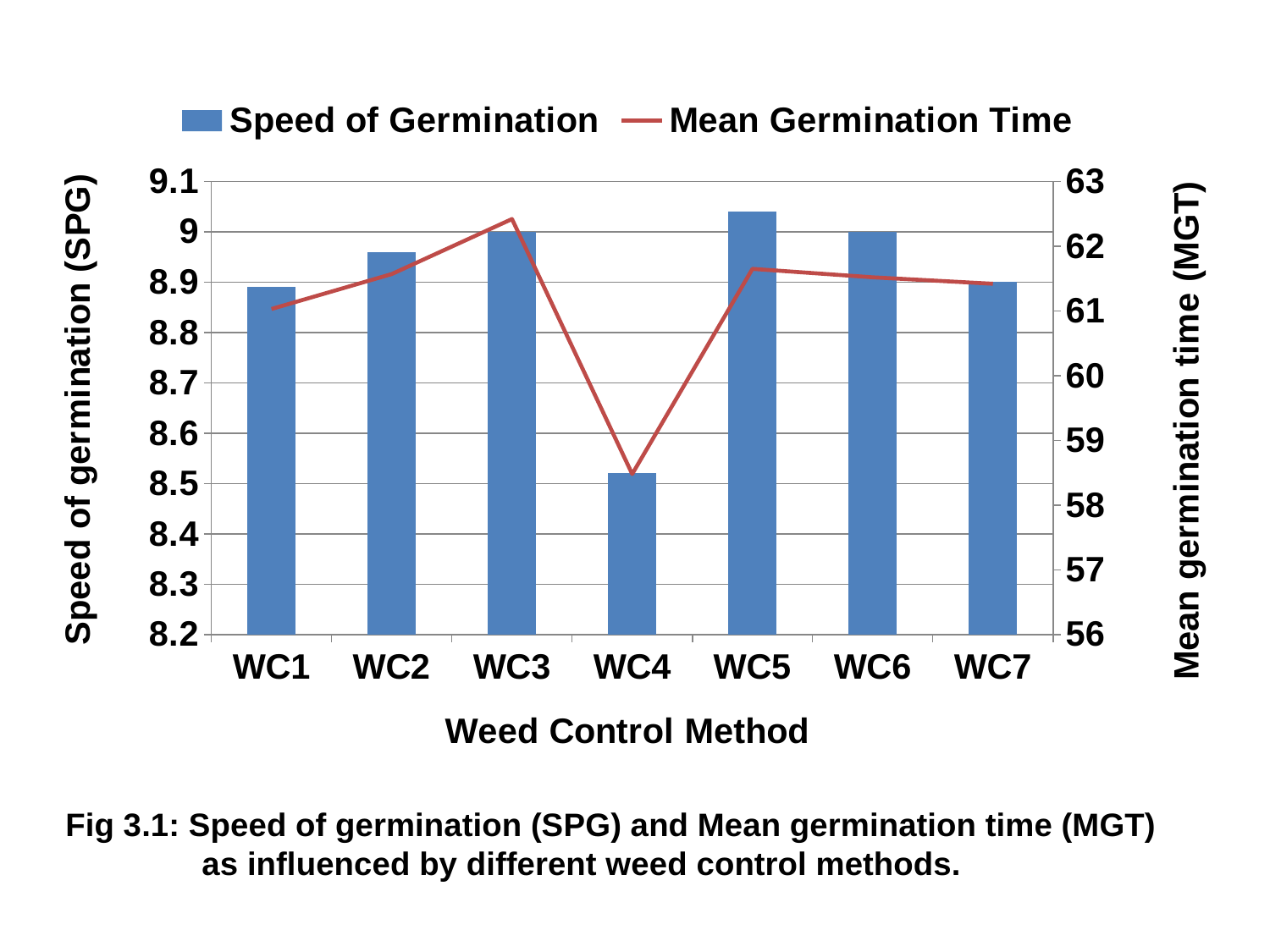
Is the Mean Germination Time for WC4 greater or less than 59? less Which weed control method has the lowest Mean Germination Time? WC4 Which weed control method has the lowest Speed of Germination? WC4 Which weed control method has the highest Speed of Germination? WC5 Which weed control method has the highest Mean Germination Time? WC3 Is the Mean Germination Time for WC3 greater or less than 62? greater How many series does the legend list? 2 How many weed control methods are shown on the x axis? 7 Which has a higher Speed of Germination, WC4 or WC5? WC5 What is the label of the right-hand vertical axis? Mean germination time (MGT) Is the Speed of Germination for WC4 greater or less than 8.6? less What kind of chart is shown on the slide? A combined bar and line chart